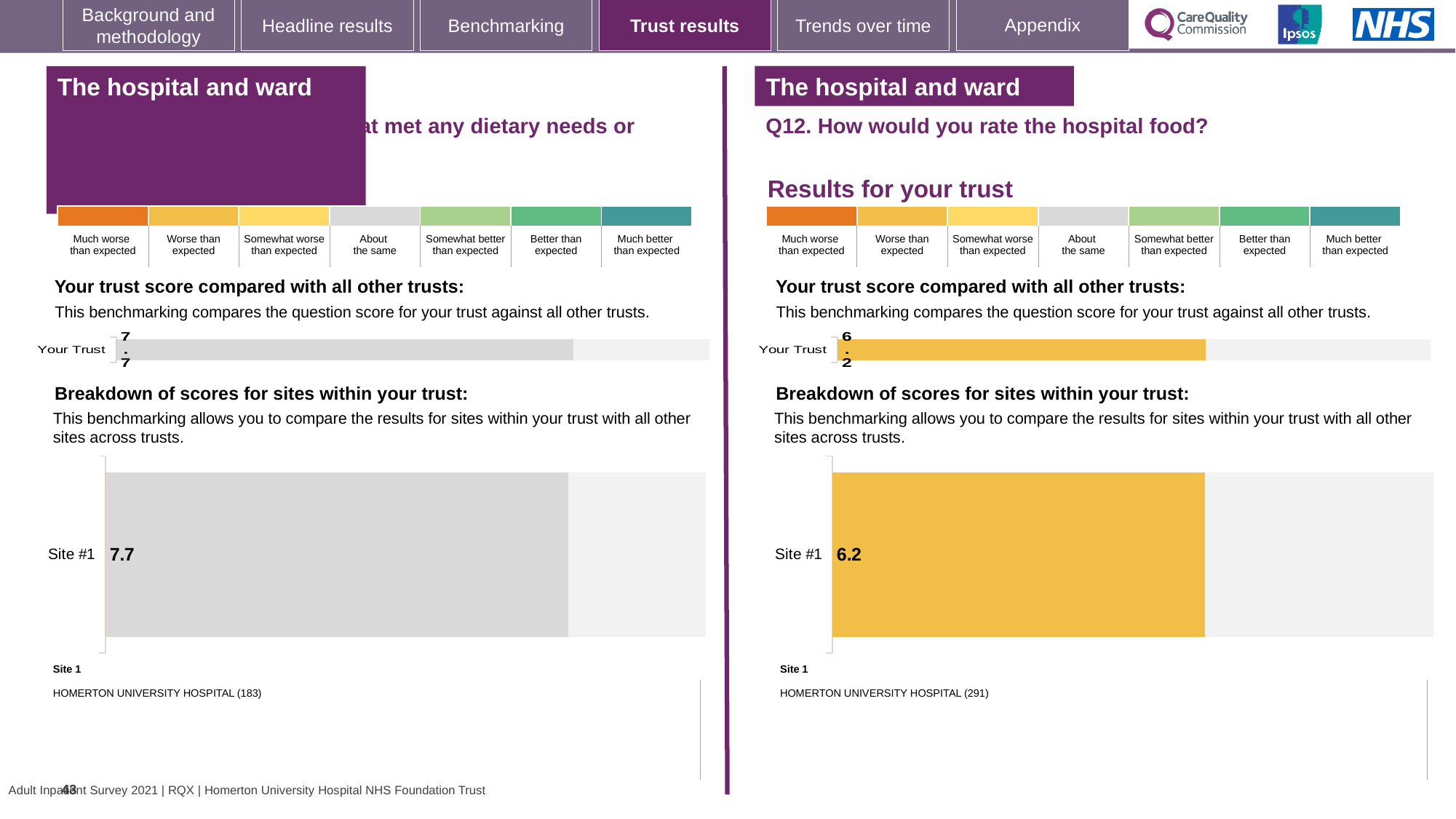
How many sites are shown in the breakdown of scores for sites on the left-hand side of the slide? 1 On the left-hand side of the slide, what is the score shown for Your Trust? 7.7 On the right-hand side of the slide (Q12. How would you rate the hospital food?), what is the score shown for Your Trust? 6.2 What is the difference between the Site #1 score on the left-hand side of the slide (7.7) and the Site #1 score on the right-hand side (6.2)? 1.5 On the right-hand side of the slide (Q12. How would you rate the hospital food?), what is the score shown for Site #1? 6.2 What kind of chart is used to show the Site #1 score on the right-hand side of the slide (Q12)? Bar chart Which site name is listed under Site 1 on the right-hand side of the slide (Q12)? HOMERTON UNIVERSITY HOSPITAL (291) On the left-hand side of the slide, what colour is the Site #1 bar? Grey On the left-hand side of the slide, what is the score shown for Site #1 in the breakdown of scores for sites? 7.7 How many sites are shown in the breakdown of scores for sites on the right-hand side of the slide (Q12)? 1 On the right-hand side of the slide (Q12), what colour is the Site #1 bar? Yellow Which is larger: the Site #1 score on the left-hand side of the slide or the Site #1 score on the right-hand side (Q12)? Left-hand side (7.7)